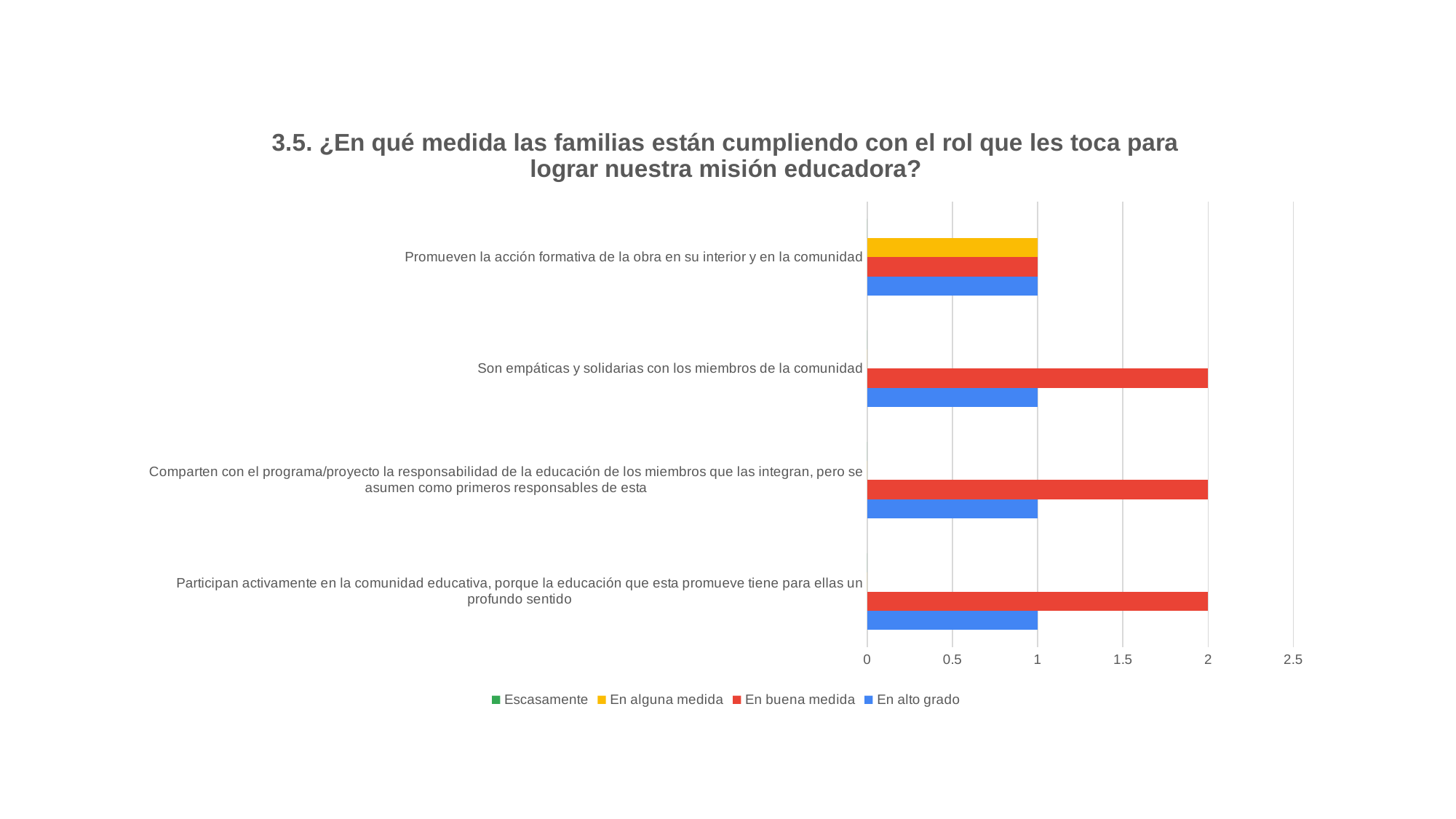
What is the value of "En buena medida" for "Comparten con el programa/proyecto la responsabilidad de la educación de los miembros que las integran, pero se asumen como primeros responsables de esta"? 2 How many categories are shown on the chart? 4 Which category is the only one with a bar for "En alguna medida"? Promueven la acción formativa de la obra en su interior y en la comunidad What is the difference between "En buena medida" and "En alto grado" for "Participan activamente en la comunidad educativa, porque la educación que esta promueve tiene para ellas un profundo sentido"? 1 How many series does the legend list? 4 What kind of chart is shown on the slide? Bar chart What is the value of "En buena medida" for "Son empáticas y solidarias con los miembros de la comunidad"? 2 For "Son empáticas y solidarias con los miembros de la comunidad", which is larger: "En buena medida" or "En alto grado"? En buena medida Is the value of "En buena medida" for "Comparten con el programa/proyecto la responsabilidad de la educación de los miembros que las integran, pero se asumen como primeros responsables de esta" greater or less than 1.5? greater What is the value of "En alguna medida" for "Promueven la acción formativa de la obra en su interior y en la comunidad"? 1 What is the value of "En alto grado" for "Participan activamente en la comunidad educativa, porque la educación que esta promueve tiene para ellas un profundo sentido"? 1 Which series is shown in red in the legend? En buena medida